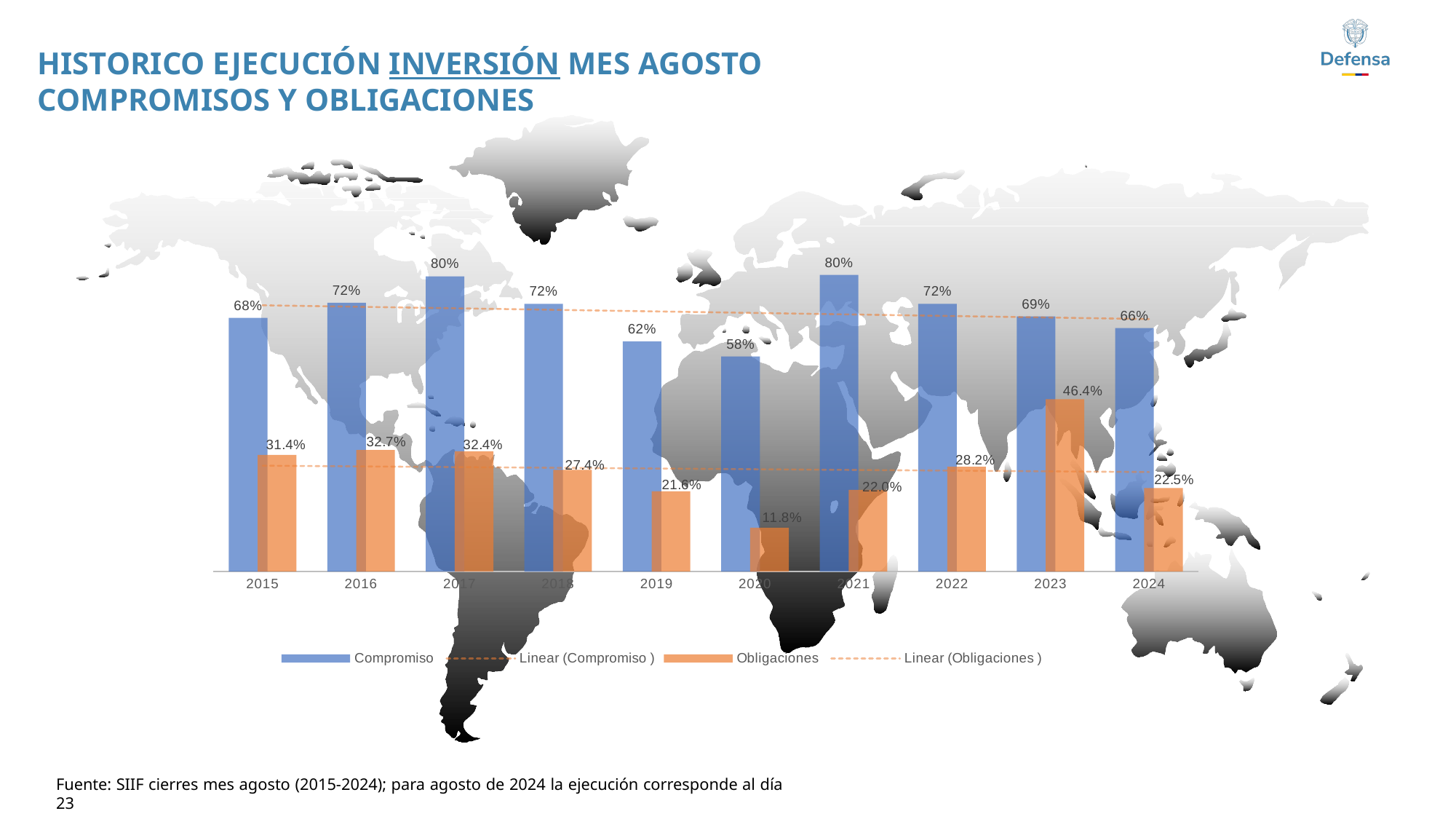
What is the difference between the Compromiso and Obligaciones values in 2023? 22.6 percentage points What is the Compromiso value for 2017? 80% Which year has the lowest Compromiso value? 2020 Which is larger, the Obligaciones value for 2016 or for 2018? 2016 What is the Compromiso value for 2024? 66% What is the Obligaciones value for 2023? 46.4% What kind of chart is shown on the slide? Bar chart How many years are shown on the x axis? 10 Which year has the highest Obligaciones value? 2023 Which year has the lowest Obligaciones value? 2020 How many entries does the legend list? 4 What is the Obligaciones value for 2020? 11.8%